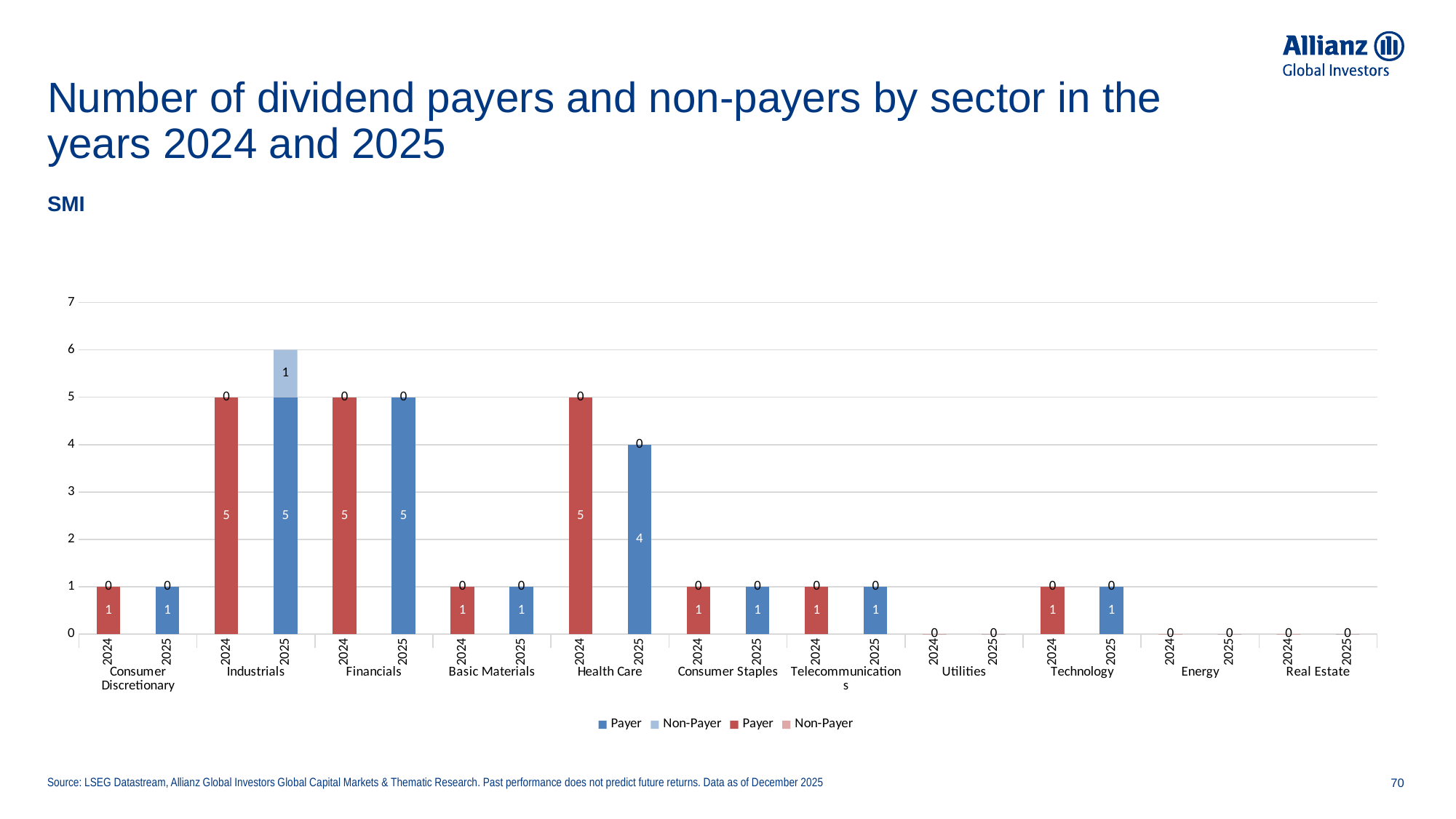
Which sector has the tallest stacked bar in 2025? Industrials How many dividend payers does the Health Care sector have in 2025? 4 What is the subtitle shown above the chart? SMI What kind of chart is shown on the slide? Stacked bar chart What is the difference between the number of dividend payers in Health Care in 2024 and in 2025? 1 How many entries does the legend list? 4 How many sectors are shown on the x axis of the chart? 11 How many dividend payers does the Utilities sector have in 2024? 0 What is the total height of the stacked bar for Industrials in 2025 (payers plus non-payers)? 6 How many non-payers does the Industrials sector have in 2025? 1 Which has more dividend payers in 2025: Financials or Health Care? Financials How many dividend payers does the Industrials sector have in 2024? 5